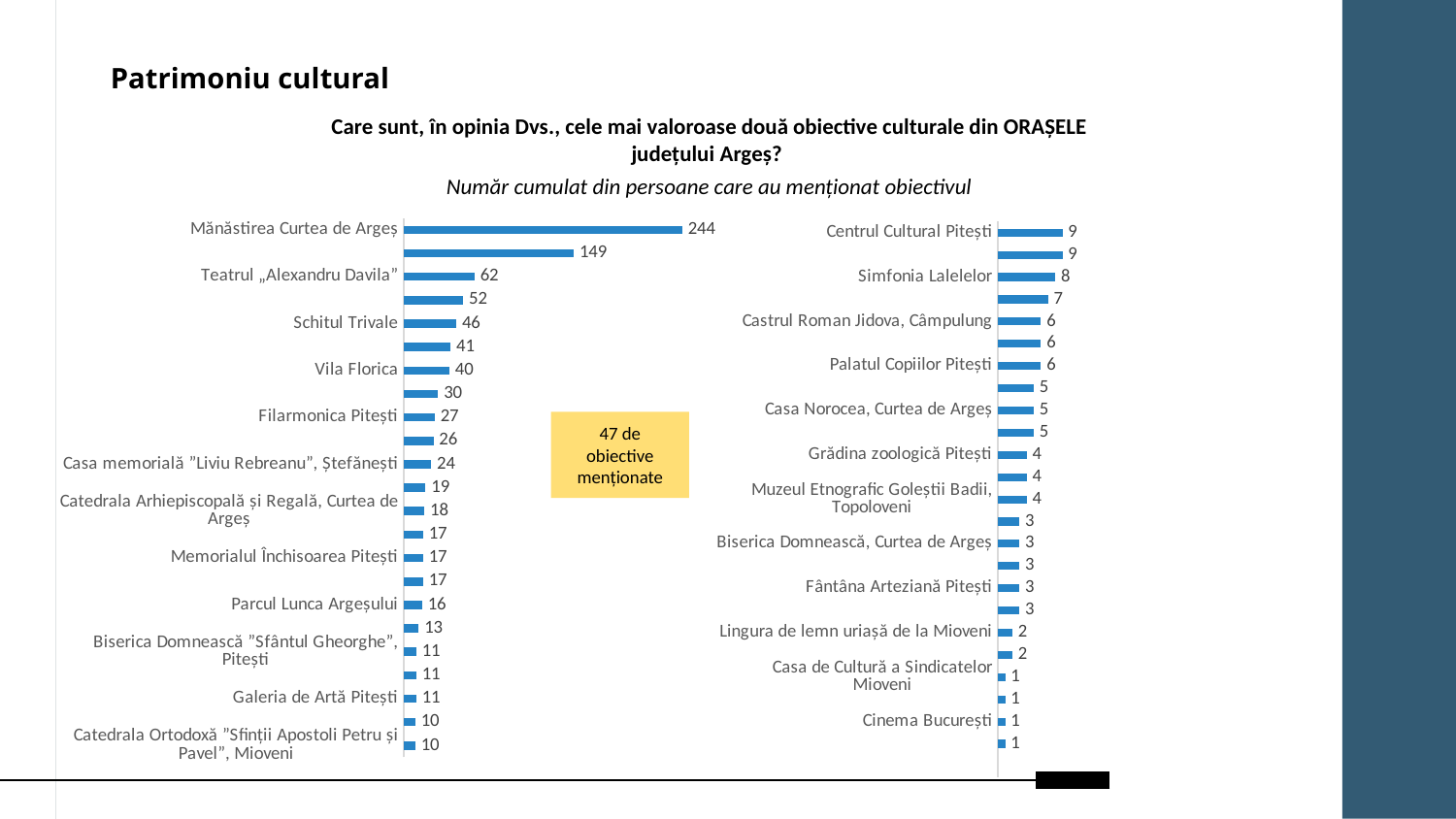
What kind of chart is used on this slide? Bar chart In the right chart, which is larger: the value for Centrul Cultural Pitești or the value for Grădina zoologică Pitești? Centrul Cultural Pitești In the right chart, what is the value for Lingura de lemn uriașă de la Mioveni? 2 In the left chart, what is the difference between the values for Mănăstirea Curtea de Argeș and Teatrul „Alexandru Davila”? 182 In the right chart, what is the difference between the values for Palatul Copiilor Pitești and Fântâna Arteziană Pitești? 3 In the left chart, which is larger: the value for Vila Florica or the value for Filarmonica Pitești? Vila Florica In the left chart, what is the value for Mănăstirea Curtea de Argeș? 244 In the left chart, which category has the highest value? Mănăstirea Curtea de Argeș In the left chart, what is the value for Schitul Trivale? 46 In the right chart, what is the value for Simfonia Lalelelor? 8 According to the text box on the slide, how many cultural objectives were mentioned in total? 47 In the left chart, what is the value for Parcul Lunca Argeșului? 16